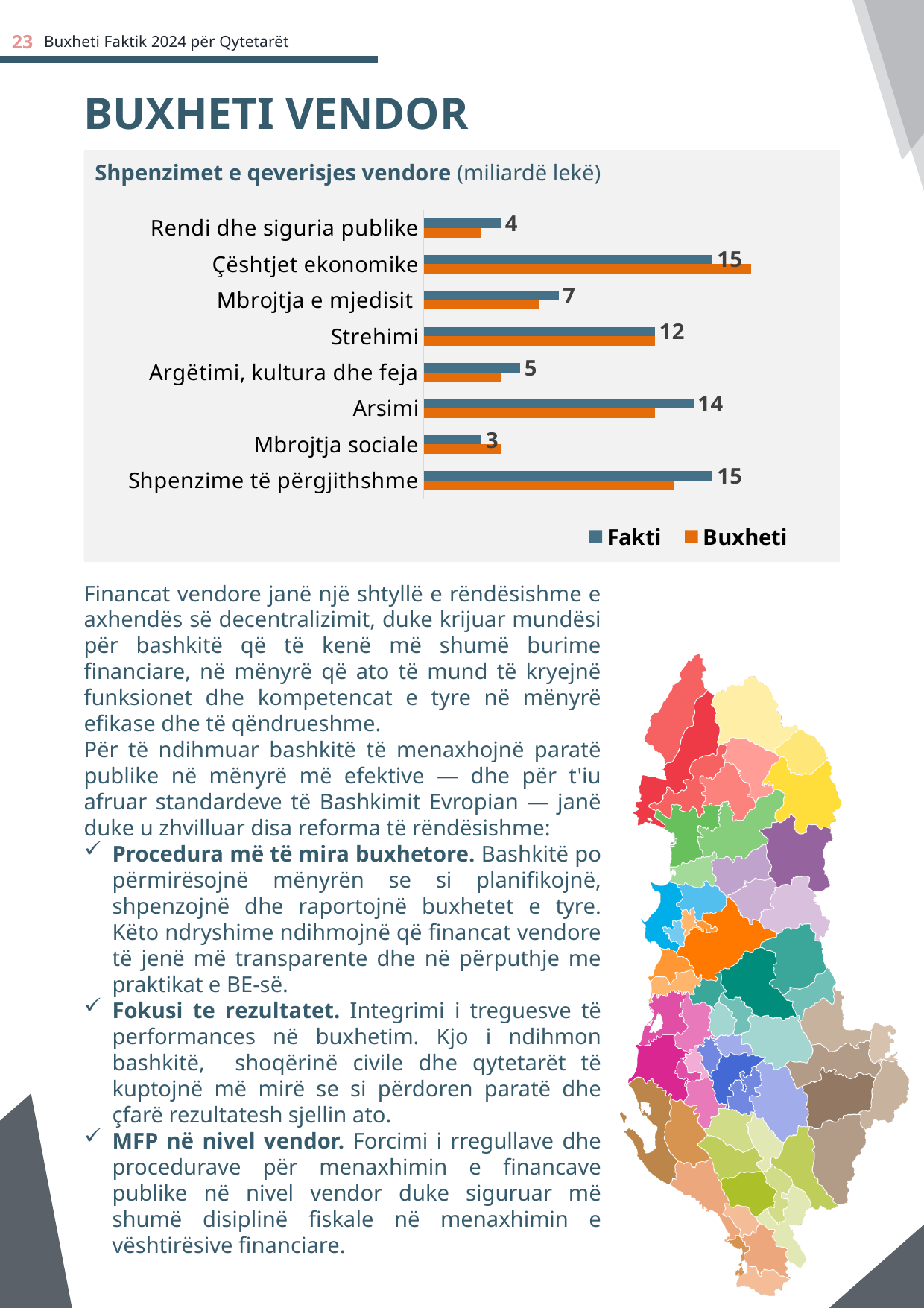
What is the Fakti value for Mbrojtja e mjedisit? 7 What is the Fakti value for Strehimi? 12 What is the Fakti value for Çështjet ekonomike? 15 What is the Fakti value for Arsimi? 14 For Shpenzime të përgjithshme, which is larger: the Fakti bar or the Buxheti bar? Fakti For Çështjet ekonomike, which is larger: the Fakti bar or the Buxheti bar? Buxheti Which category has the lowest Fakti value? Mbrojtja sociale What is the difference between the Fakti values for Çështjet ekonomike and Mbrojtja sociale? 12 How many categories are shown in the chart? 8 What is the difference between the Fakti values for Arsimi and Strehimi? 2 What type of chart is shown on the slide? Bar chart How many series does the legend list? 2